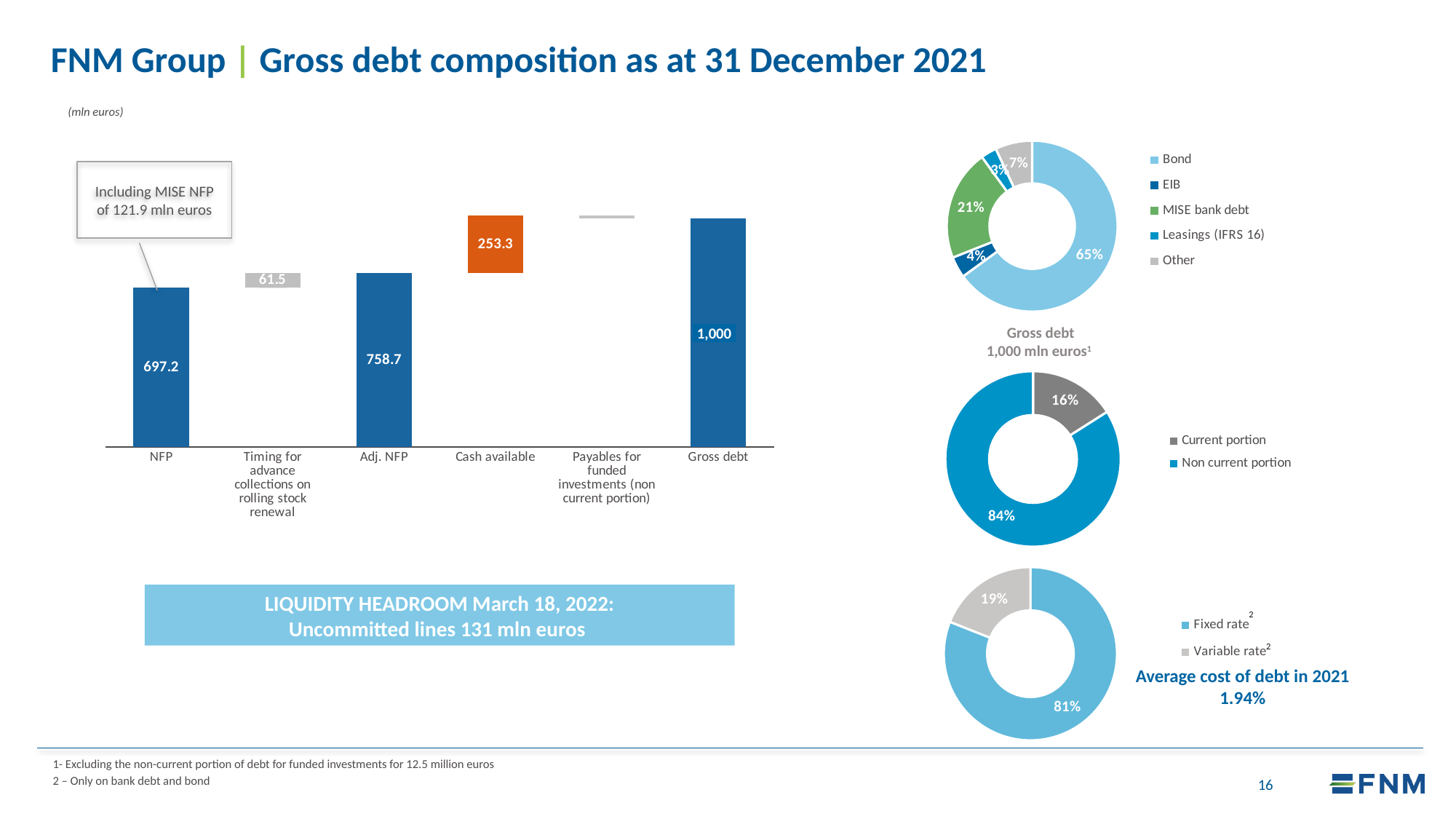
In the bar chart on the left, what is the value for Gross debt? 1,000 In the bar chart on the left, how many categories are shown on the x axis? 6 In the top donut chart (Gross debt 1,000 mln euros), what share is Bond? 65% In the bar chart on the left, which is larger: Cash available or NFP? NFP In the bar chart on the left, what is the value for NFP? 697.2 In the top donut chart (Gross debt 1,000 mln euros), which category has the smallest share? Leasings (IFRS 16) In the top donut chart (Gross debt 1,000 mln euros), what share is MISE bank debt? 21% In the bar chart on the left, what is the value for Adj. NFP? 758.7 In the bar chart on the left, what is the difference between Adj. NFP and NFP? 61.5 In the bottom donut chart, what share is Variable rate? 19% In the bar chart on the left, what is the value for Cash available? 253.3